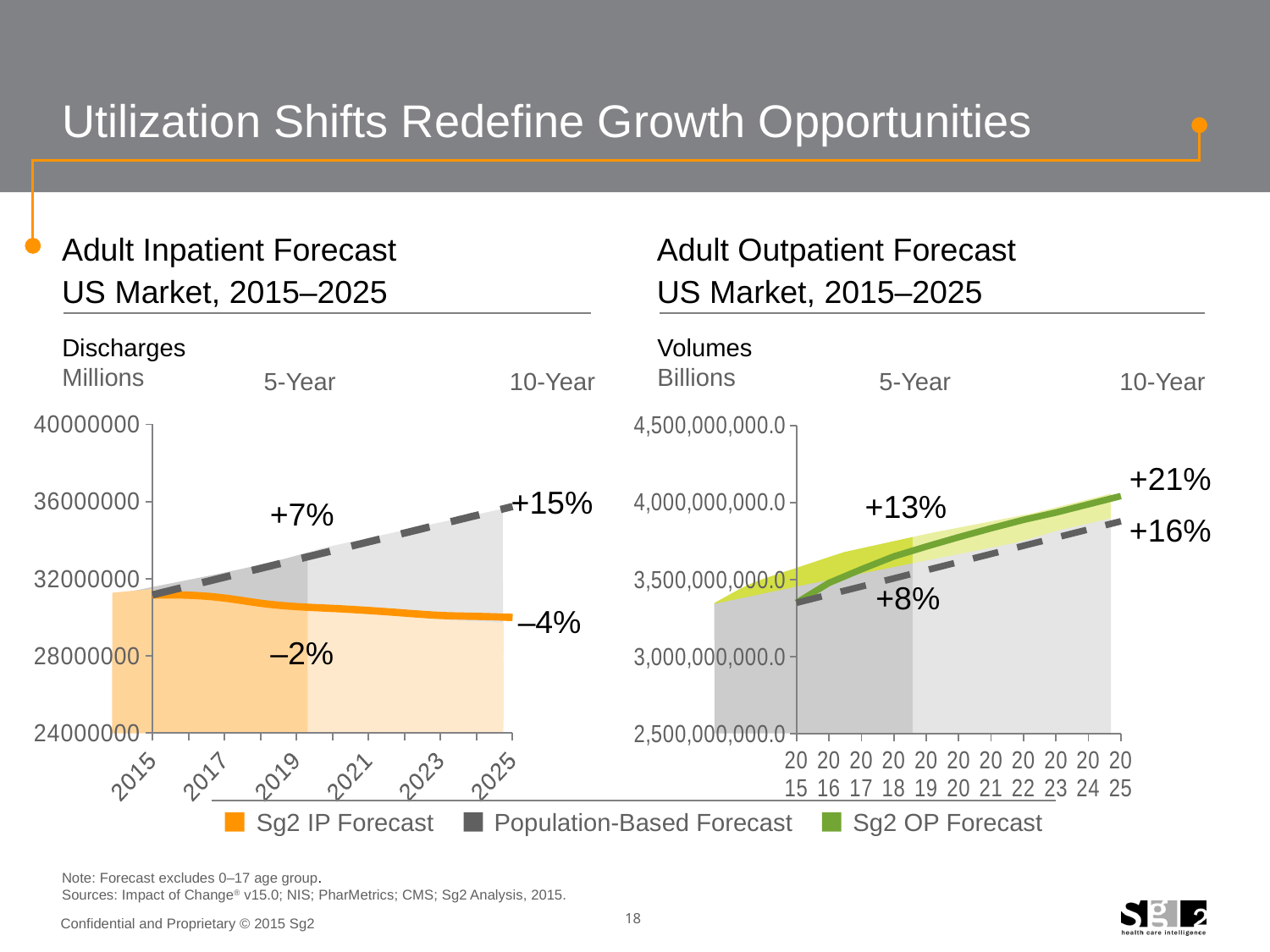
On the Adult Outpatient Forecast chart, what is the 5-year change shown for the Population-Based Forecast? +8% What kind of chart is the Adult Inpatient Forecast chart? Line chart How many series does the shared legend below the charts list? 3 On the Adult Outpatient Forecast chart, what is the 10-year change shown for the Sg2 OP Forecast? +21% On the Adult Inpatient Forecast chart, which series shows the larger 10-year change, the Sg2 IP Forecast or the Population-Based Forecast? Population-Based Forecast On the Adult Inpatient Forecast chart, what is the 10-year change shown for the Population-Based Forecast? +15% On the Adult Outpatient Forecast chart, does the Sg2 OP Forecast line rise or fall from 2015 to 2025? Rise On the Adult Inpatient Forecast chart, does the Sg2 IP Forecast line rise or fall from 2015 to 2025? Fall On the Adult Outpatient Forecast chart, how many percentage points higher is the Sg2 OP Forecast 10-year change than the Population-Based Forecast 10-year change? 5 percentage points On the Adult Inpatient Forecast chart, is the Sg2 IP Forecast value in 2025 greater or less than 32000000? less On the Adult Outpatient Forecast chart, is the 2015 value greater or less than 3,500,000,000.0? less On the Adult Inpatient Forecast chart, what is the 5-year change shown for the Sg2 IP Forecast? –2%